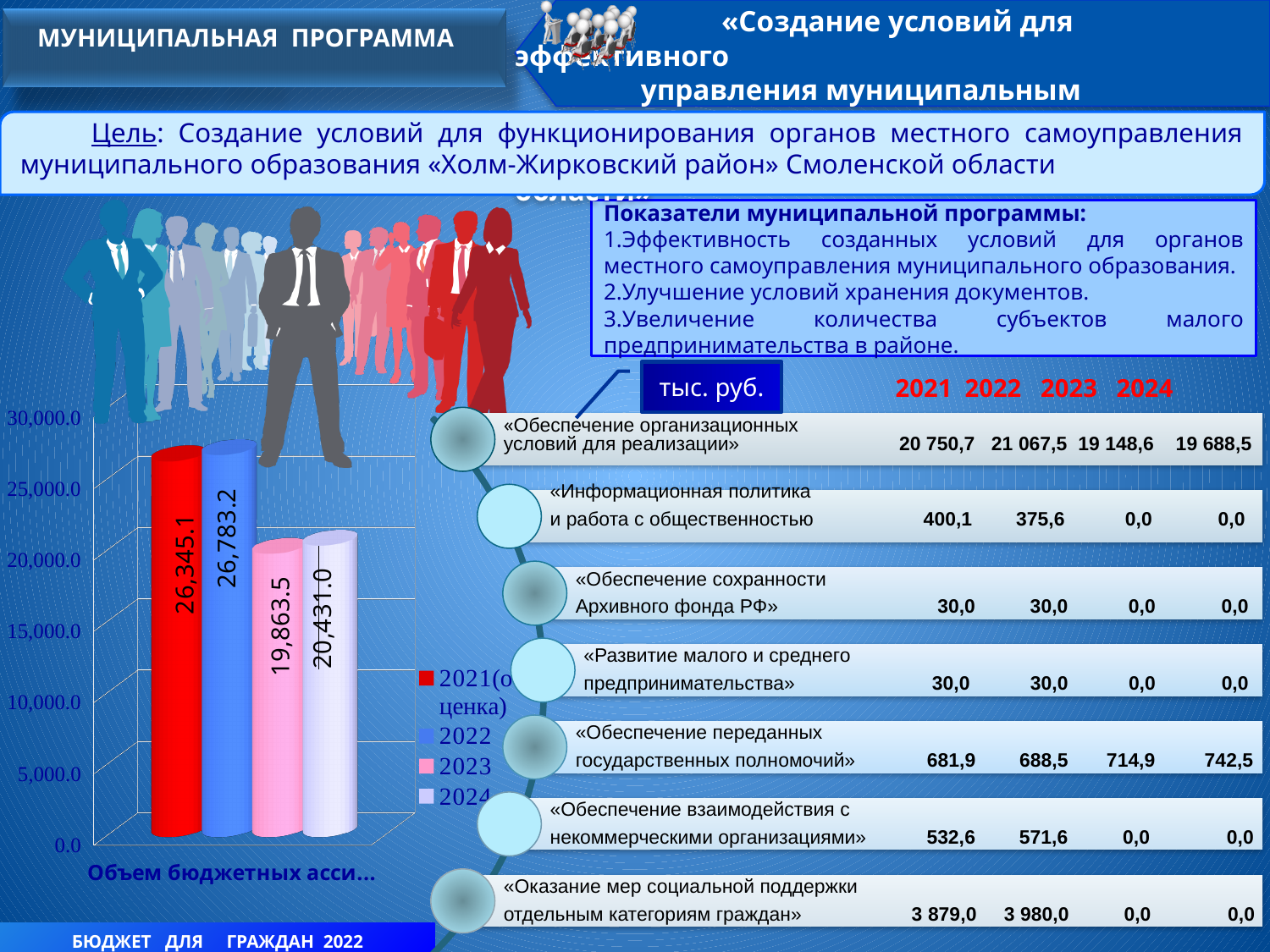
Which year has the highest value in the chart? 2022 What is the value of the 2024 bar in the chart? 20,431.0 How many series does the chart legend list? 4 What type of chart is shown on the slide? bar chart What is the value of the 2022 bar in the chart? 26,783.2 What is the value of the 2021(оценка) bar in the chart? 26,345.1 Which is larger in the chart, the value for 2024 or the value for 2023? 2024 What is the value of the 2023 bar in the chart? 19,863.5 What is the difference between the 2022 value and the 2023 value in the chart? 6,919.7 Which year has the lowest value in the chart? 2023 Is the value for 2023 in the chart greater or less than 20,000.0? less What colour is the 2021(оценка) bar in the chart? red